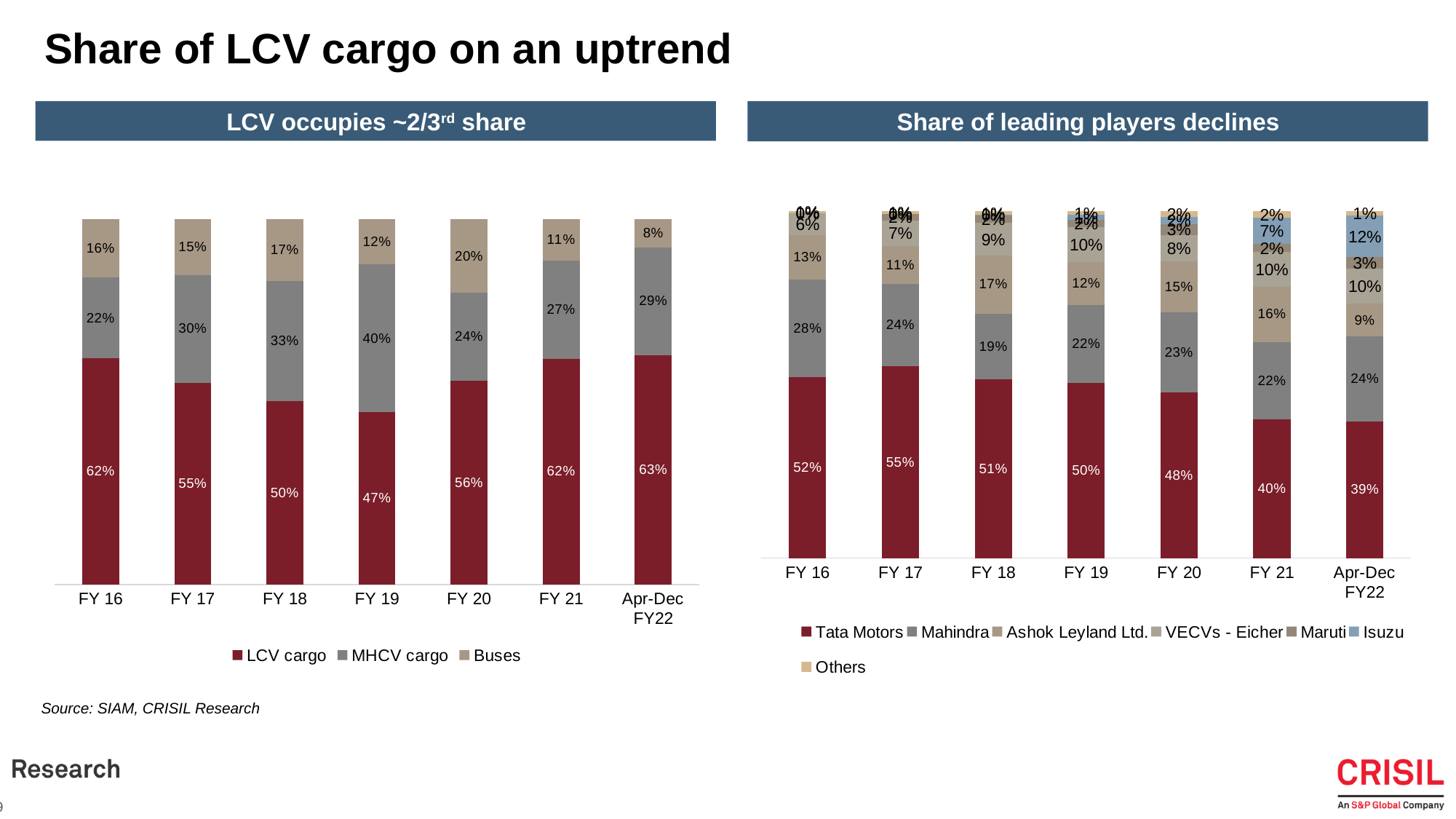
In the 'Share of leading players declines' chart, what is Tata Motors' share in FY 20? 48% In the 'Share of leading players declines' chart, is Ashok Leyland Ltd.'s share larger in FY 18 or in Apr-Dec FY22? FY 18 In the 'LCV occupies ~2/3rd share' chart, how many series does the legend list? 3 In the 'LCV occupies ~2/3rd share' chart, which period has the lowest LCV cargo share? FY 19 In the 'Share of leading players declines' chart, which period has the highest Tata Motors share? FY 17 In the 'LCV occupies ~2/3rd share' chart, what is the difference between the MHCV cargo share in FY 19 and FY 16? 18 percentage points In the 'Share of leading players declines' chart, what is Isuzu's share in Apr-Dec FY22? 12% In the 'LCV occupies ~2/3rd share' chart, what is the Buses share in Apr-Dec FY22? 8% In the 'LCV occupies ~2/3rd share' chart, what is the LCV cargo share in FY 19? 47% In the 'Share of leading players declines' chart, what is Mahindra's share in FY 18? 19% What type of chart is the 'Share of leading players declines' chart? Stacked bar chart In the 'LCV occupies ~2/3rd share' chart, what is the MHCV cargo share in FY 17? 30%